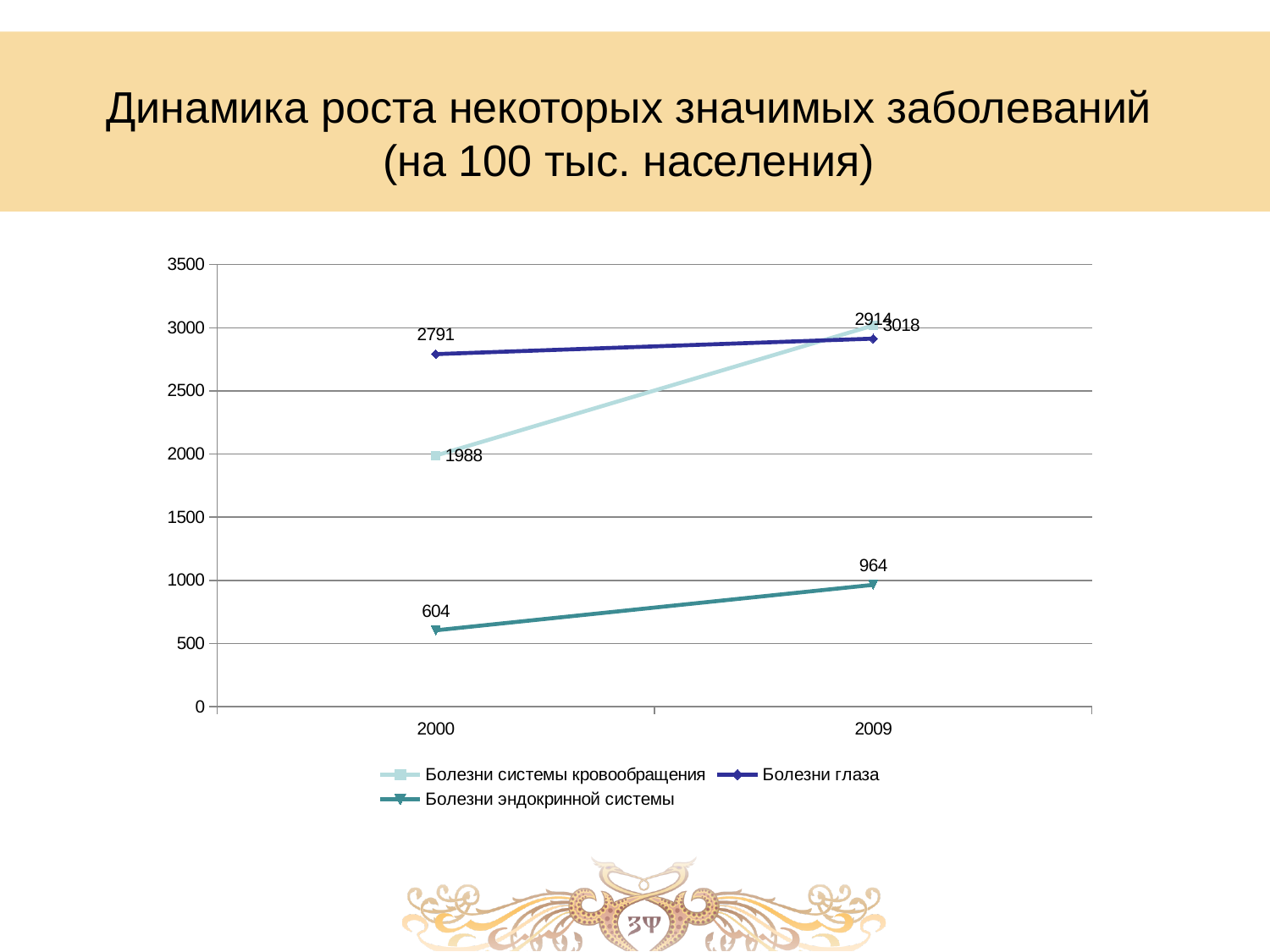
Which is larger in 2000: Болезни глаза or Болезни системы кровообращения? Болезни глаза Does the value for Болезни системы кровообращения rise or fall from 2000 to 2009? rise What type of chart is shown on the slide? line chart How many series does the legend list? 3 Which series has the highest value in 2000? Болезни глаза By how much did Болезни эндокринной системы increase from 2000 to 2009? 360 What is the value for Болезни глаза in 2009? 2914 What is the value for Болезни эндокринной системы in 2009? 964 Which series has the lowest value in 2009? Болезни эндокринной системы What is the value for Болезни системы кровообращения in 2000? 1988 How many years are shown on the x axis? 2 What is the value for Болезни эндокринной системы in 2000? 604